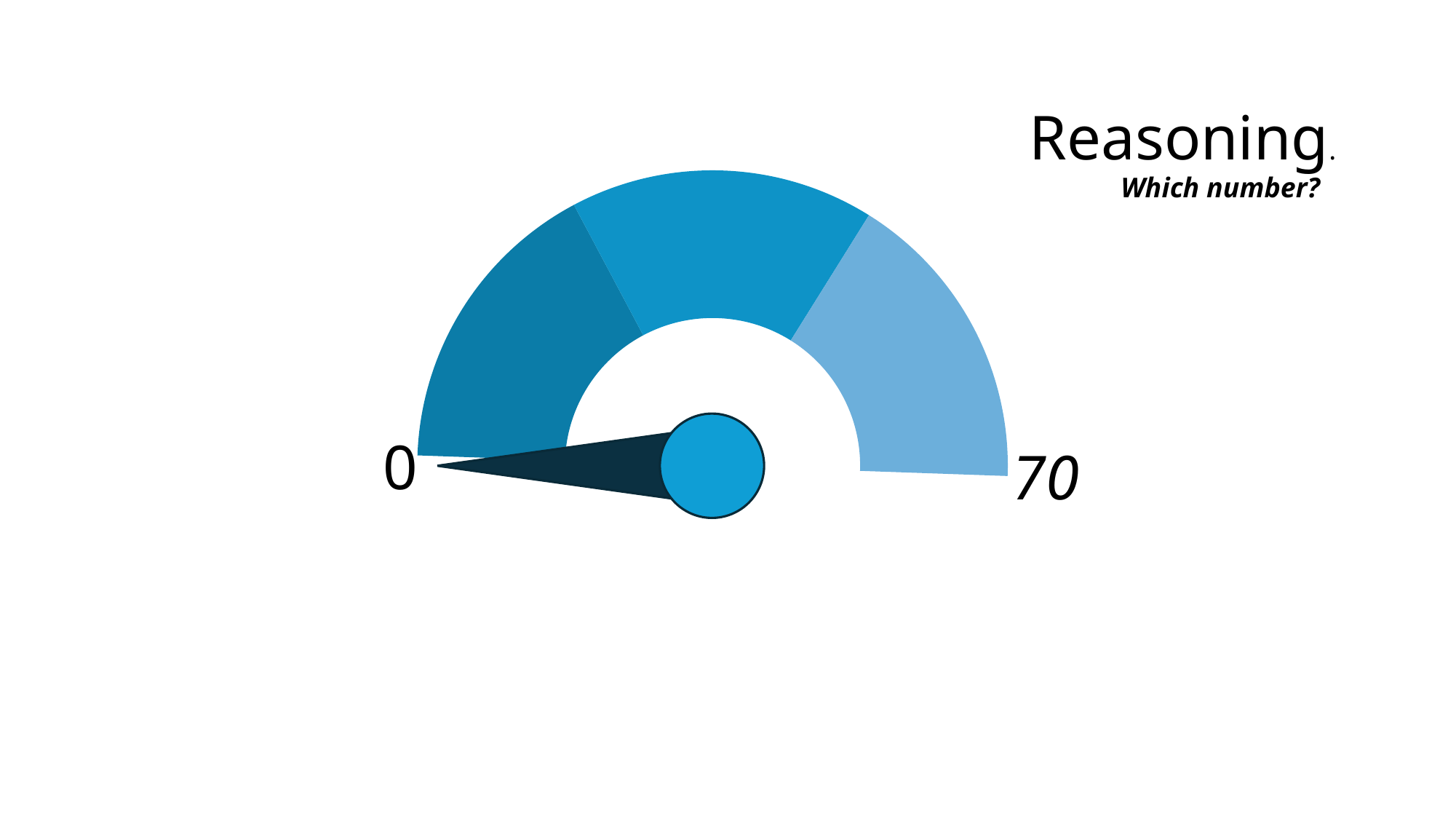
What is the title of the chart on the slide? Reasoning. How many coloured segments make up the gauge arc? 3 What is the maximum value shown on the gauge scale? 70 What is the difference between the maximum and minimum values on the gauge scale? 70 What value does the needle of the gauge point to? 0 What kind of chart is shown on the slide? gauge chart What subtitle appears under the chart title? Which number? What is the minimum value shown on the gauge scale? 0 Is the value indicated by the needle greater or less than 70? less